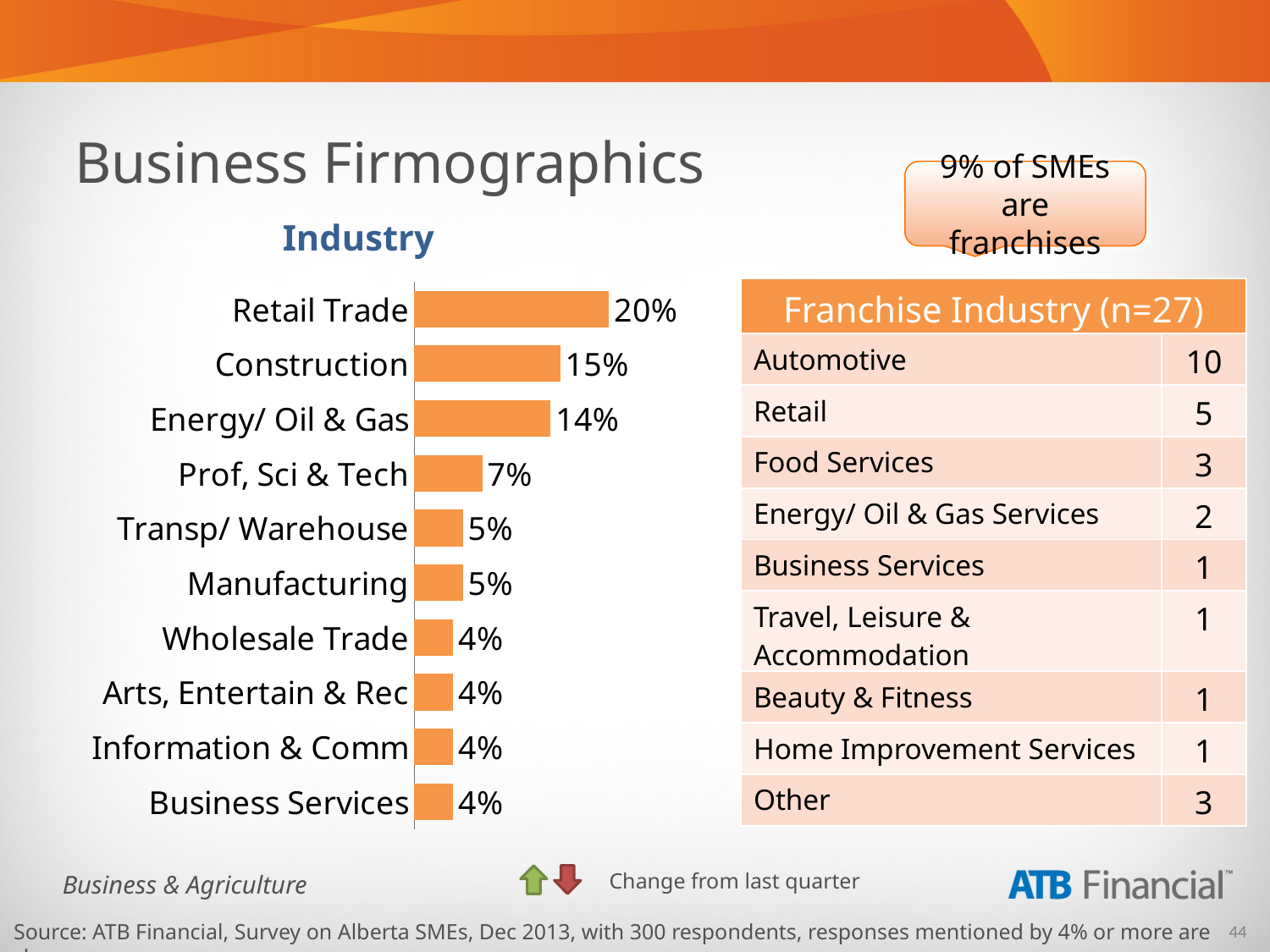
What is the title of the bar chart on the slide? Industry What is the value for Energy/ Oil & Gas in the Industry chart? 14% What is the difference between the values for Construction and Energy/ Oil & Gas in the Industry chart? 1% How many industry categories are shown in the Industry chart? 10 What is the difference between the values for Retail Trade and Construction in the Industry chart? 5% Which industry has the highest share in the Industry chart? Retail Trade What kind of chart is the Industry chart? Bar chart What is the value for Retail Trade in the Industry chart? 20% How many categories in the Industry chart have a value of 4%? 4 Which is larger in the Industry chart, Construction or Transp/ Warehouse? Construction Which is larger in the Industry chart, Prof, Sci & Tech or Manufacturing? Prof, Sci & Tech What is the value for Prof, Sci & Tech in the Industry chart? 7%